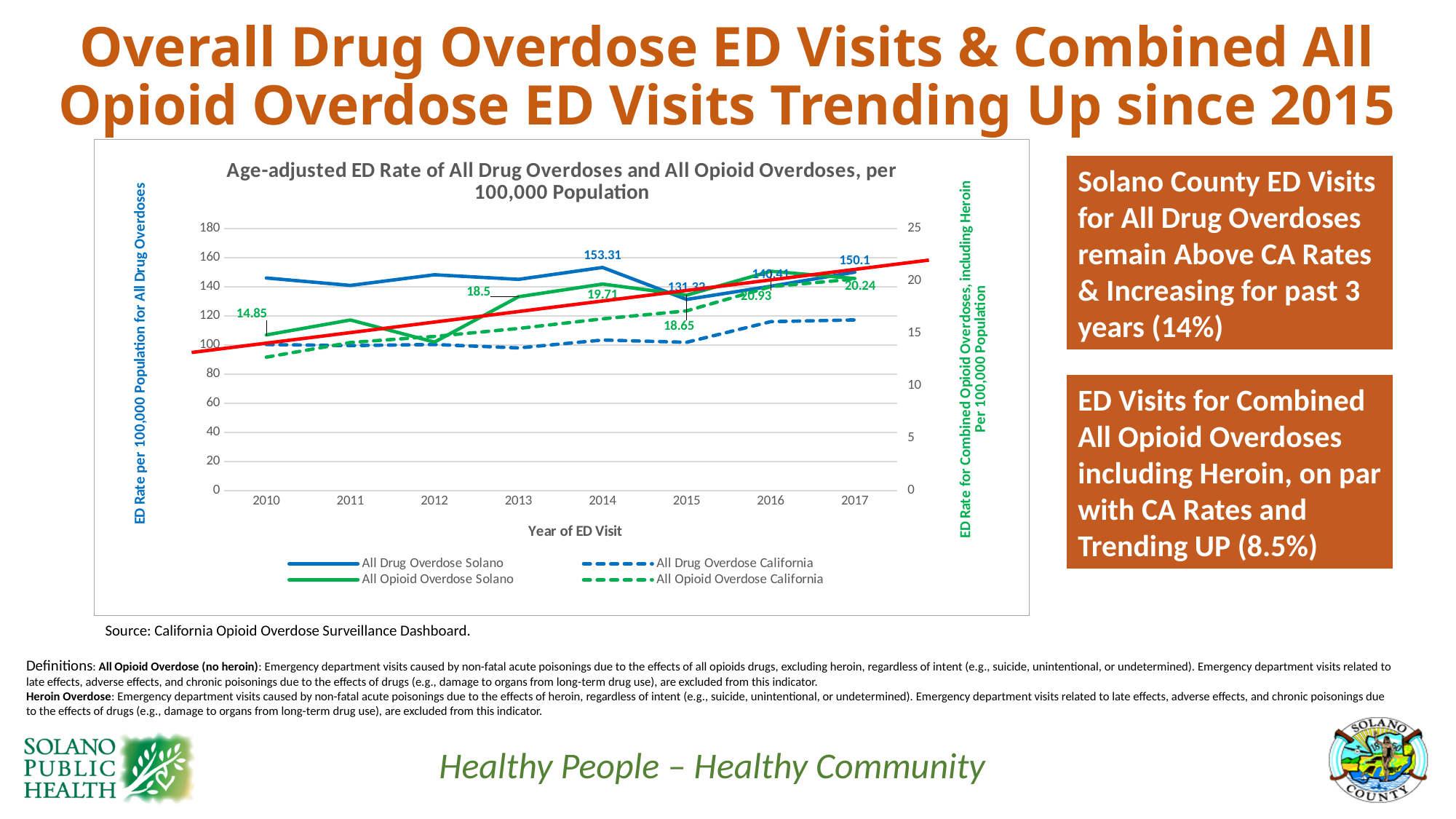
How many years are plotted on the x axis? 8 What kind of chart is shown on the slide? line chart What is the All Opioid Overdose Solano rate in 2016? 20.93 Which year has the higher All Opioid Overdose Solano rate, 2016 or 2017? 2016 What is the All Drug Overdose Solano rate in 2017? 150.1 By how much did the All Drug Overdose Solano rate fall from 2014 to 2015? 21.99 What is the All Opioid Overdose Solano rate in 2010? 14.85 Does the All Drug Overdose Solano line rise or fall from 2015 to 2017? rise What is the title of the x axis? Year of ED Visit Is the All Drug Overdose California value for 2010 greater or less than 120? less What is the All Drug Overdose Solano rate in 2014? 153.31 How many series does the chart legend list? 4